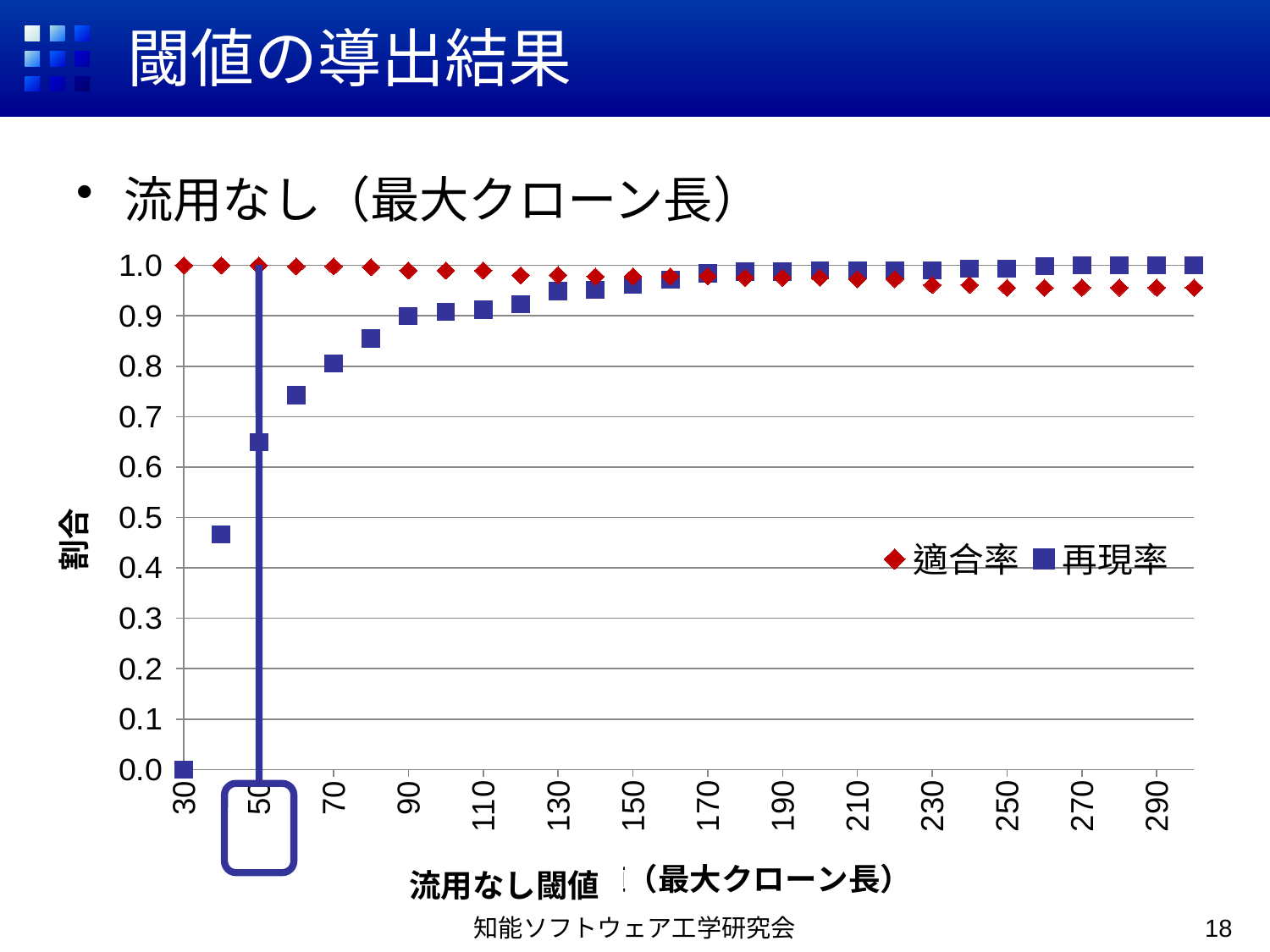
Is the value of 再現率 at a threshold of 50 greater or less than 0.6? greater At a threshold of 50, which series has the larger value, 適合率 or 再現率? 適合率 Does 再現率 generally rise or fall as the threshold increases along the x axis? rise At which threshold value is 再現率 lowest? 30 How many series does the legend list? 2 What is the value of 適合率 at a threshold of 30? 1.0 Is the value of 再現率 at a threshold of 80 greater or less than 0.8? greater What is the value of 再現率 at a threshold of 30? 0.0 What kind of chart is shown on the slide? scatter chart Is the value of 再現率 at a threshold of 40 greater or less than 0.5? less What is the title of the y axis? 割合 What are the two series named in the legend? 適合率 and 再現率